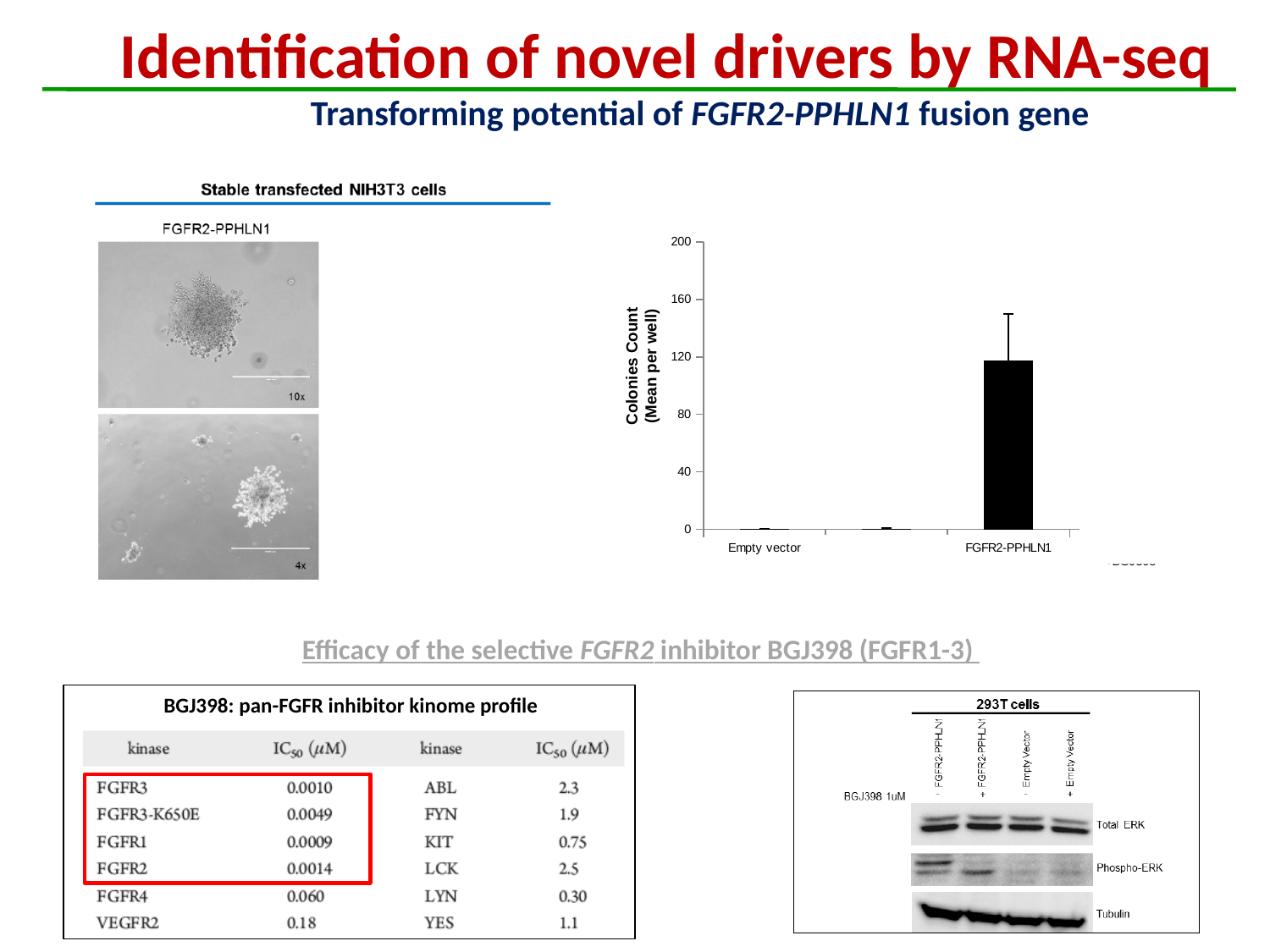
Is the colonies count for FGFR2-PPHLN1 greater or less than 160? less How many categories are shown on the x axis of the colonies count chart? 2 What is the maximum value shown on the y axis of the bar chart? 200 What kind of chart is used to show the colonies count? bar chart Which category has the highest colonies count in the bar chart? FGFR2-PPHLN1 In the bar chart, which has a larger colonies count, Empty vector or FGFR2-PPHLN1? FGFR2-PPHLN1 Is the colonies count for Empty vector greater or less than 40? less Is the colonies count for FGFR2-PPHLN1 greater or less than 80? greater Which category has the lowest colonies count in the bar chart? Empty vector What is the label of the y axis in the bar chart? Colonies Count (Mean per well)